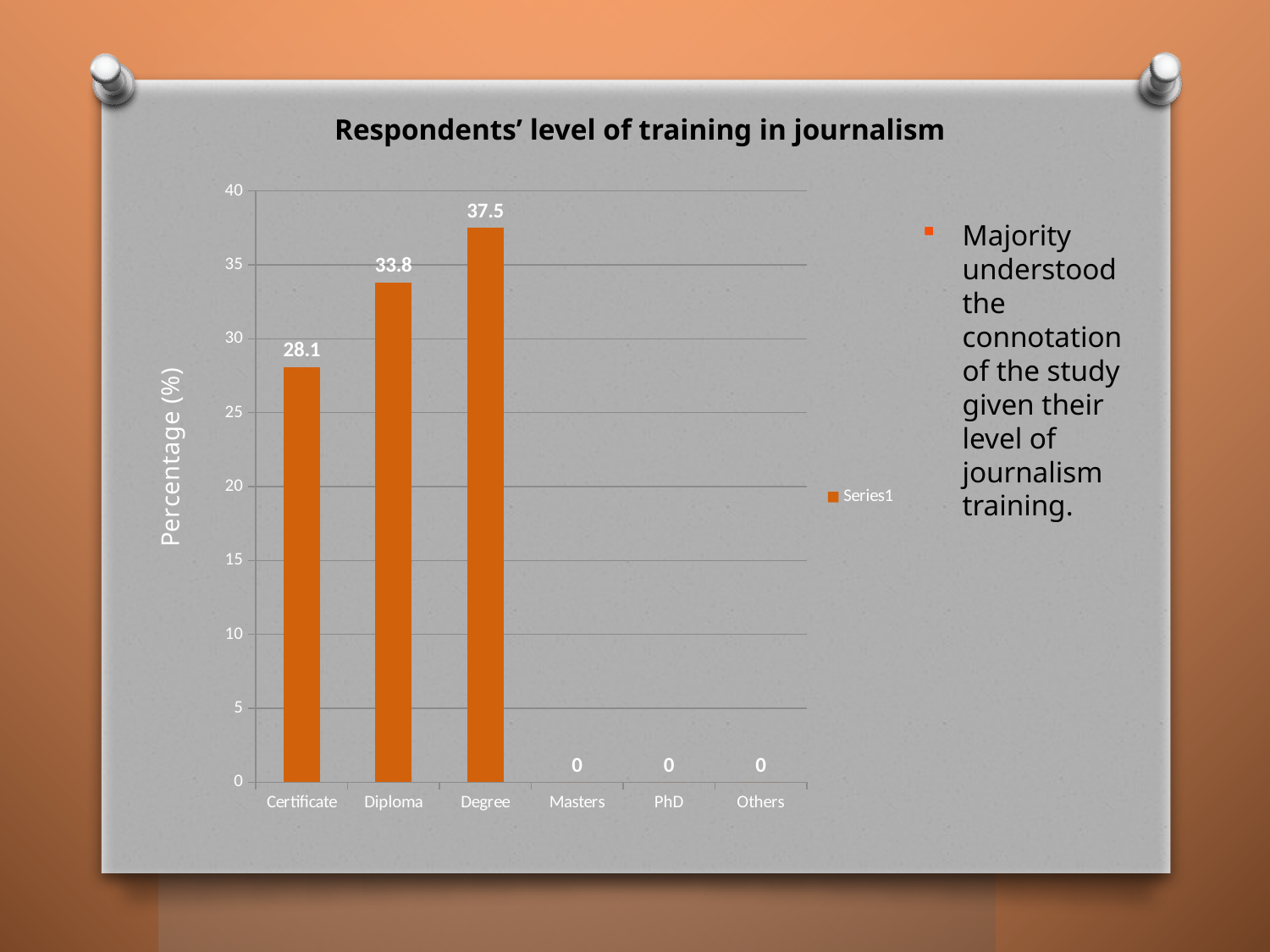
What is the value for Masters? 0 What is the title of the chart? Respondents' level of training in journalism What is the difference between the values for Diploma and Certificate? 5.7 Which is larger, the value for Diploma or the value for Certificate? Diploma What is the value for Certificate? 28.1 What is the value for Degree? 37.5 What is the difference between the values for Degree and Certificate? 9.4 What is the value for Diploma? 33.8 Is the value for Degree greater or less than 35? greater What kind of chart is shown? bar chart Which category has the highest value? Degree How many categories are shown on the x axis? 6